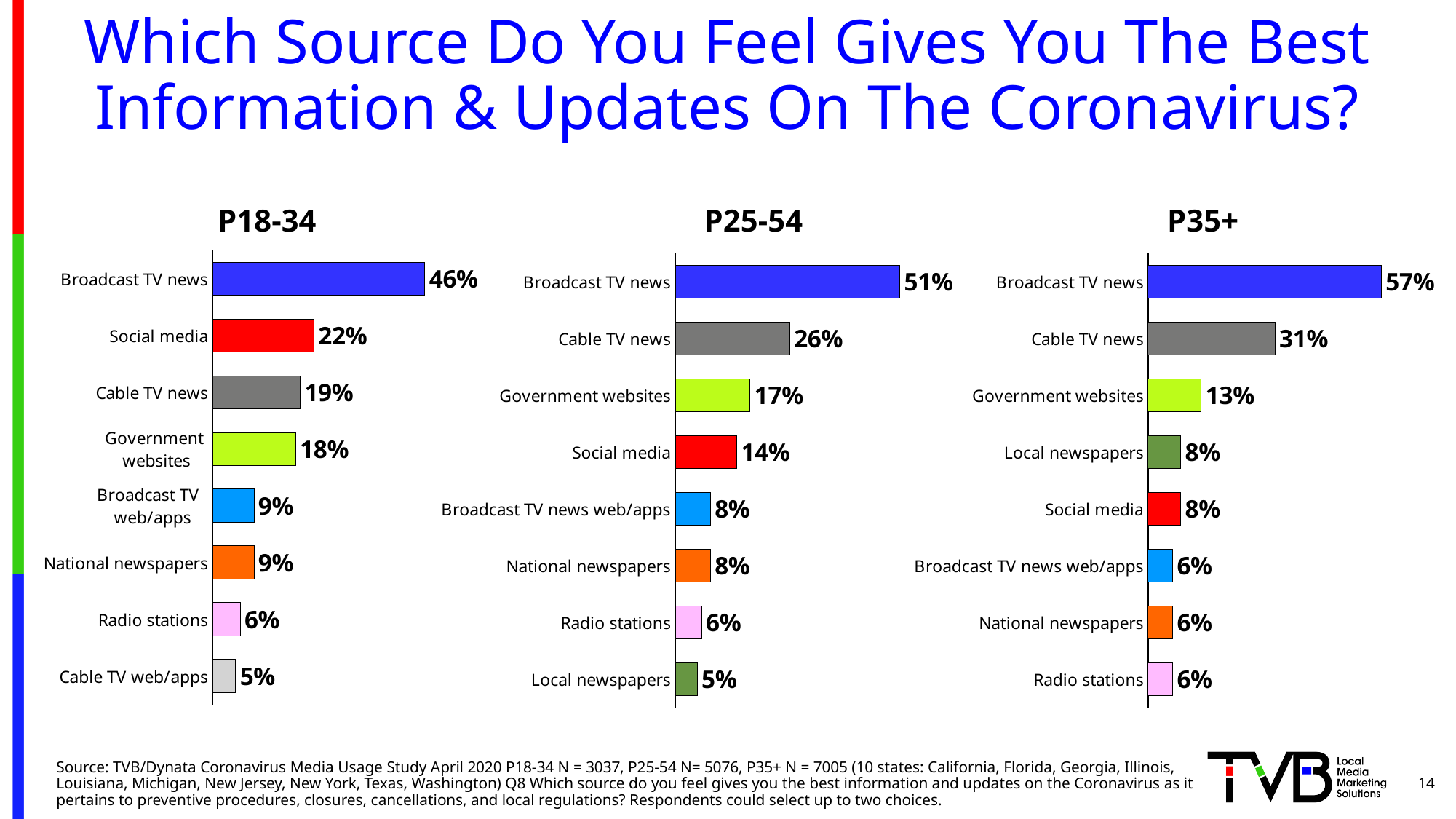
In the P35+ chart, what percentage is shown for Cable TV news? 31% In the P25-54 chart, which source has the lowest value? Local newspapers In the P35+ chart, which source has the highest value? Broadcast TV news In the P25-54 chart, what is the difference between Broadcast TV news and Cable TV news? 25% In the P18-34 chart, what percentage is shown for Social media? 22% In the P18-34 chart, which source has the lowest value? Cable TV web/apps What type of chart is used for the P18-34 data? Bar chart What is the title of the chart on the right side of the slide? P35+ How many sources are listed in the P25-54 chart? 8 In the P18-34 chart, which is larger: Social media or Cable TV news? Social media In the P25-54 chart, what percentage is shown for Government websites? 17% In the P35+ chart, what is the difference between Cable TV news and Government websites? 18%